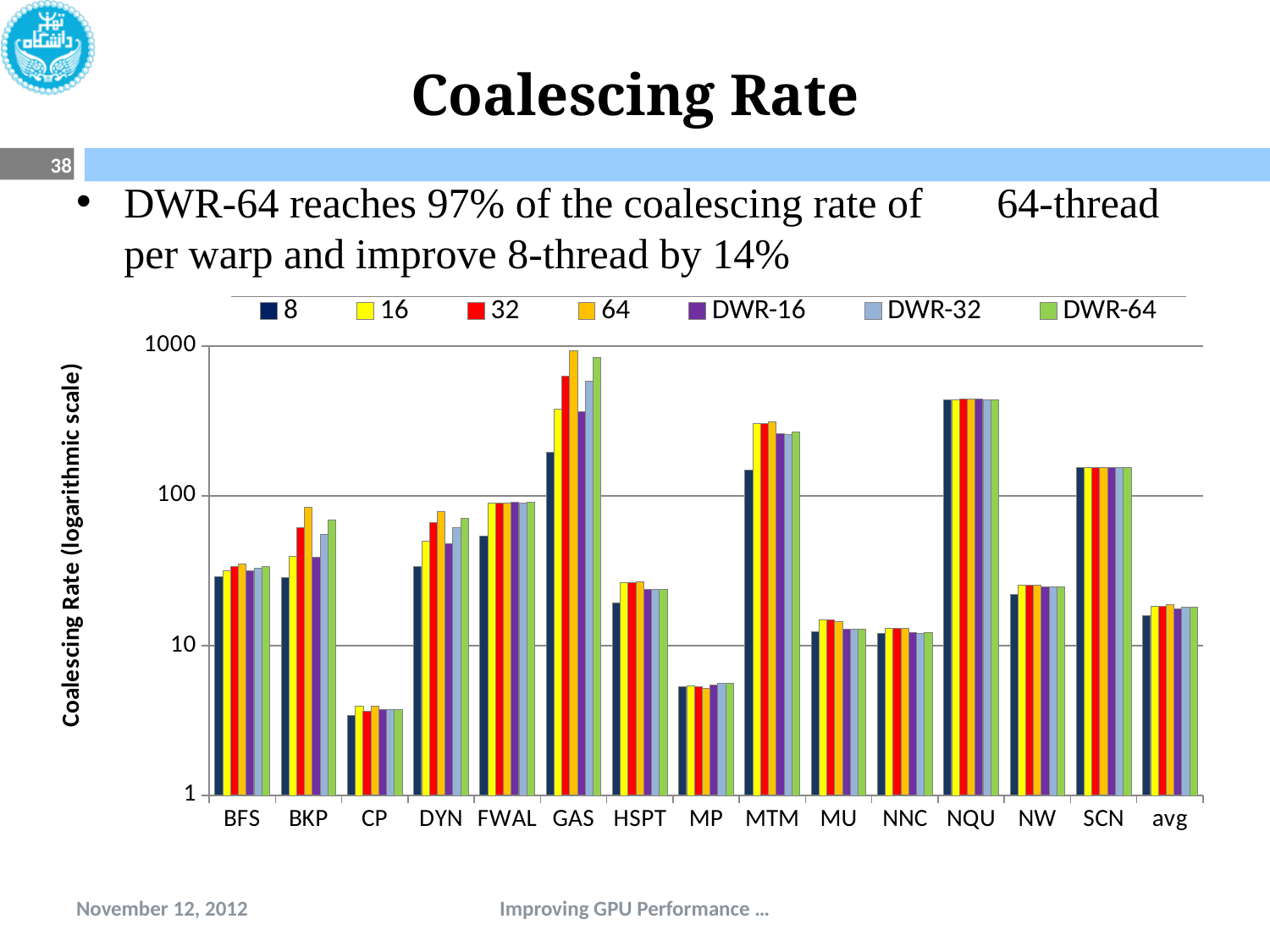
How many categories are shown on the x axis? 15 Which category has the lowest coalescing rate values? CP What is the label of the vertical axis? Coalescing Rate (logarithmic scale) Is the value for the 8 series at NQU greater or less than 100? greater How many series does the legend list? 7 Which is larger at BKP, the value for the 64 series or the value for the 8 series? 64 Which category has larger values, NQU or NW? NQU Is the value for the DWR-64 series at BFS greater or less than 100? less Is the value for the 8 series at CP greater or less than 10? less What kind of chart is shown on the slide? bar chart Which category has the highest coalescing rate values? GAS